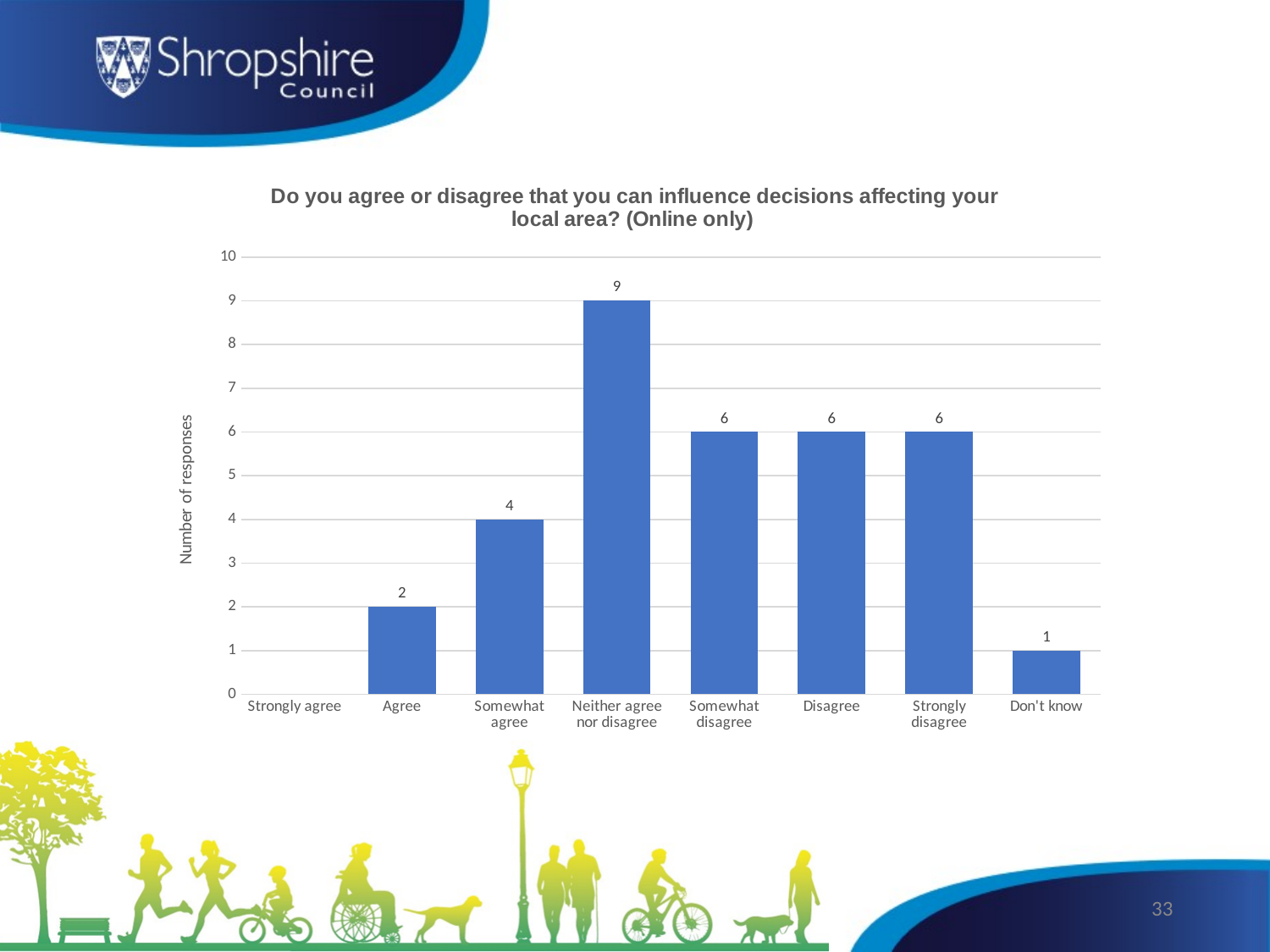
What is the difference in responses between 'Neither agree nor disagree' and 'Somewhat disagree'? 3 How many responses are shown for 'Agree'? 2 How many responses are shown for 'Don't know'? 1 Which category has the highest number of responses? Neither agree nor disagree How many categories have exactly 6 responses? 3 How many response categories are shown on the x axis? 8 What kind of chart is shown on the slide? Bar chart What is the label of the vertical axis? Number of responses Which has more responses, 'Agree' or 'Somewhat agree'? Somewhat agree How many responses are shown for 'Somewhat agree'? 4 What is the difference in responses between 'Somewhat agree' and 'Agree'? 2 How many responses are shown for 'Neither agree nor disagree'? 9